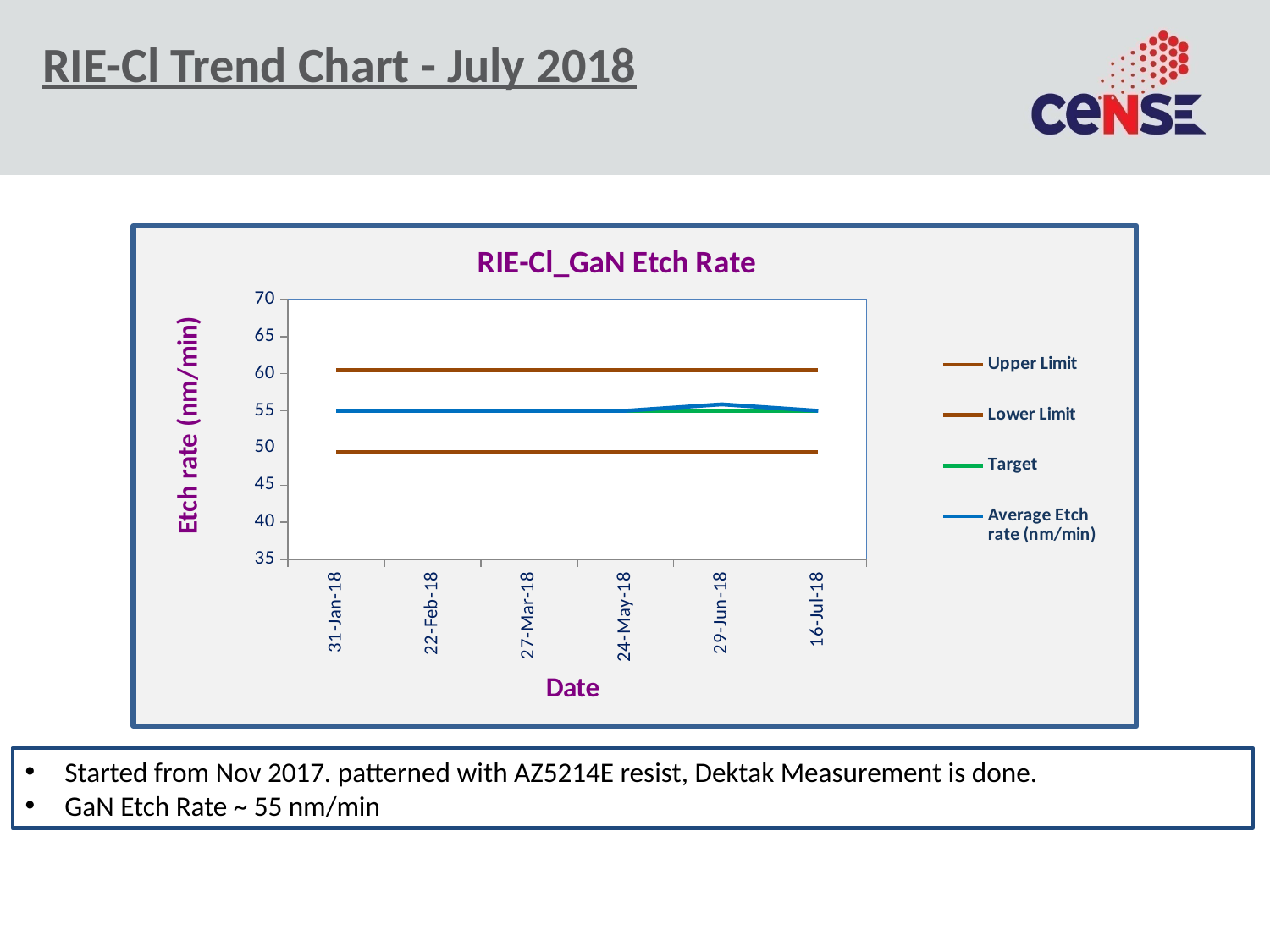
Is the value of the Lower Limit line greater or less than 45? greater Is the value of the Upper Limit line greater or less than 65? less How many date labels are shown on the x axis? 6 What is the y-axis title of the chart? Etch rate (nm/min) What is the value of the Target line? 55 Which series has the lowest values on the chart? Lower Limit What kind of chart is shown on the slide? line chart How many series does the legend list? 4 Which is larger, the Upper Limit or the Lower Limit? Upper Limit Which series has the highest values on the chart? Upper Limit What is the title of the chart? RIE-Cl_GaN Etch Rate Does the Target line rise, fall, or stay flat across the dates? stays flat